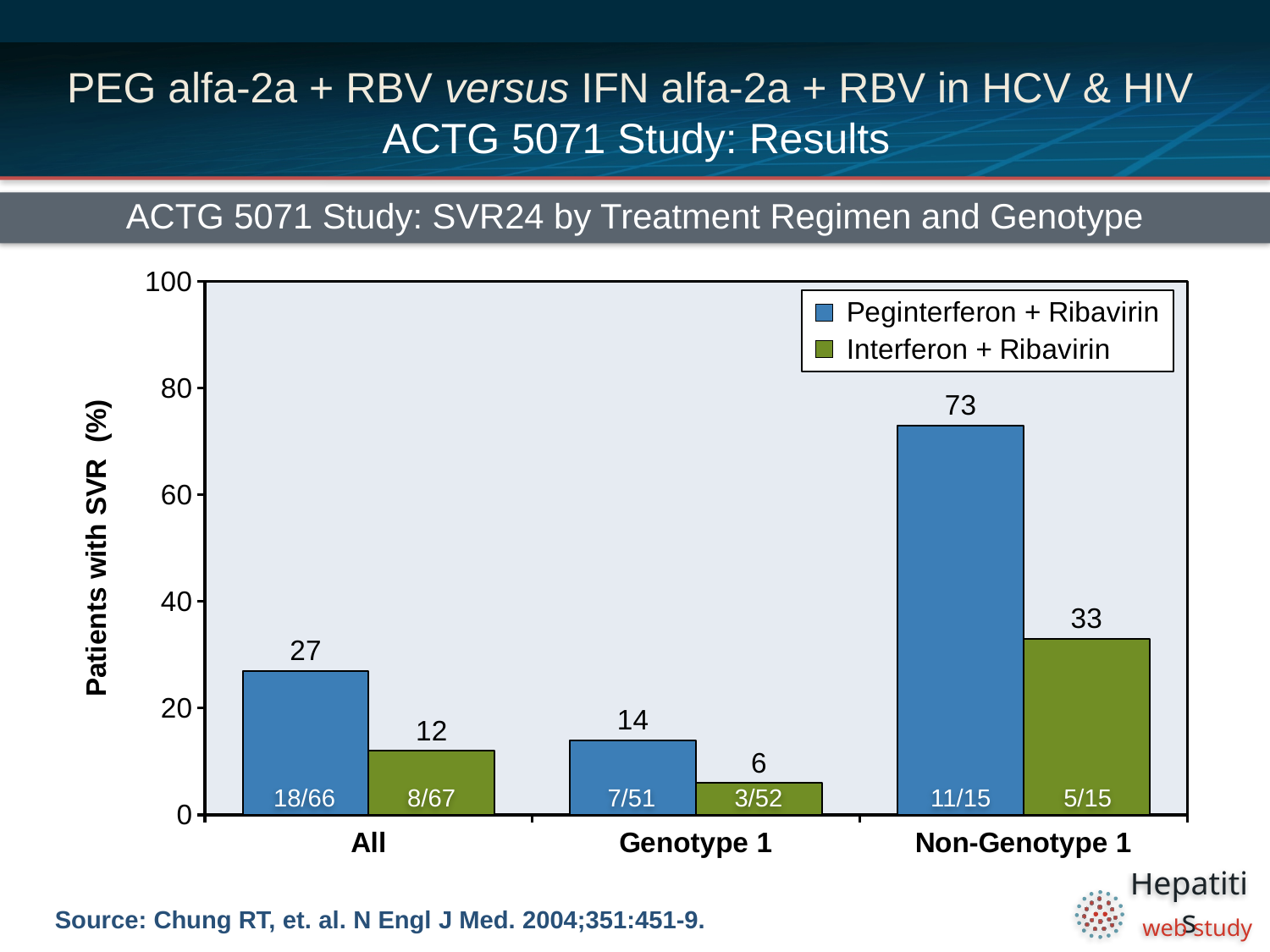
How many genotype groups are shown on the x axis? 3 How many series does the legend list? 2 What is the label of the y axis? Patients with SVR (%) What kind of chart is shown on the slide? Bar chart Which genotype group has the lowest SVR rate for Interferon + Ribavirin? Genotype 1 What fraction of patients is shown inside the Interferon + Ribavirin bar for the All group? 8/67 What is the SVR rate for Peginterferon + Ribavirin in the Non-Genotype 1 group? 73 What is the SVR rate for Interferon + Ribavirin in the Genotype 1 group? 6 What is the SVR rate for Peginterferon + Ribavirin in the All group? 27 What is the difference between the Peginterferon + Ribavirin and Interferon + Ribavirin SVR rates in the Non-Genotype 1 group? 40 In the Genotype 1 group, which regimen has the higher SVR rate? Peginterferon + Ribavirin Which genotype group has the highest SVR rate for Peginterferon + Ribavirin? Non-Genotype 1